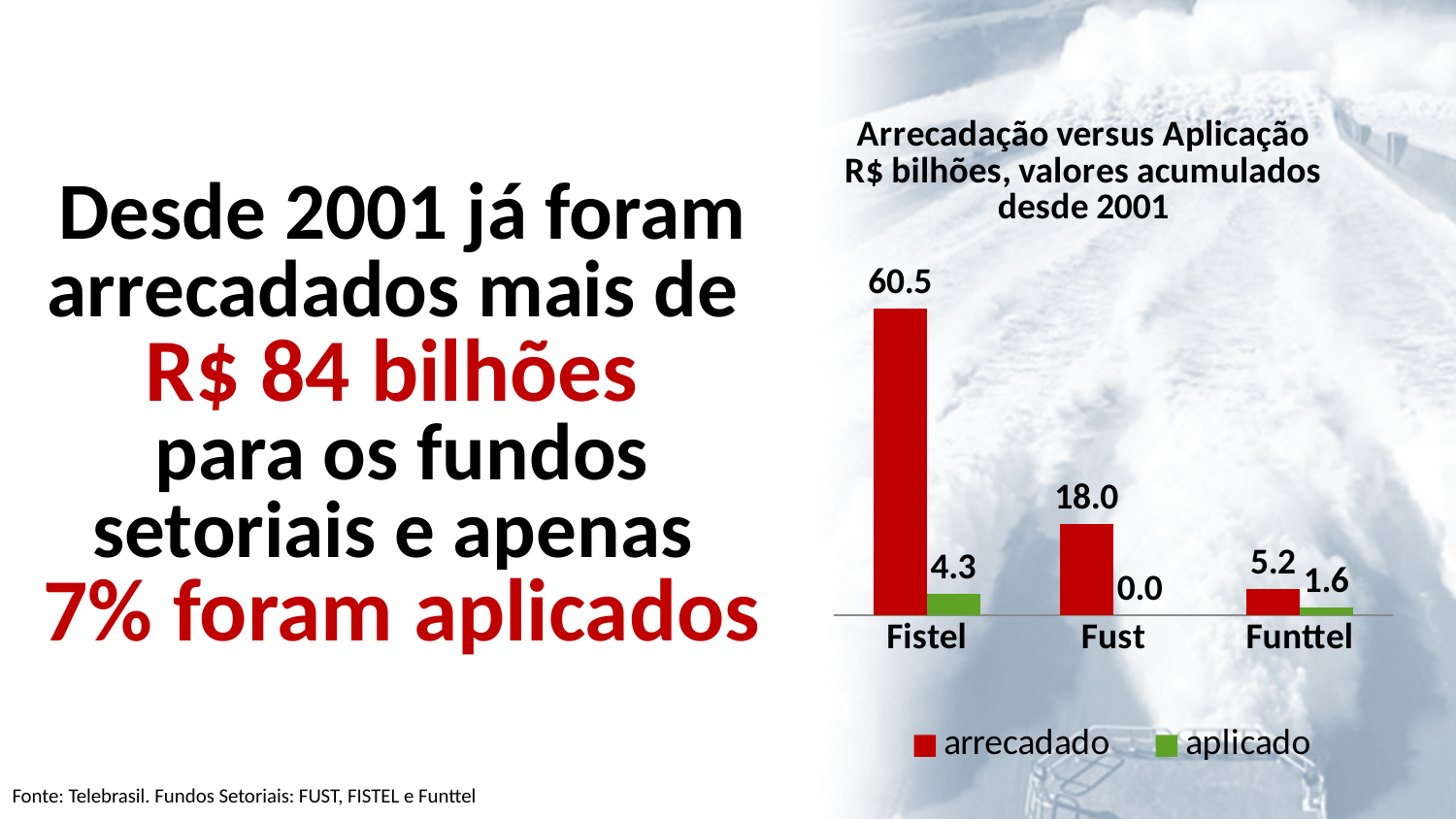
What is the 'arrecadado' value for Fust? 18.0 What is the 'arrecadado' value for Fistel? 60.5 How many series does the legend list? 2 Which is larger: the 'arrecadado' value for Fust or the 'arrecadado' value for Funttel? Fust What is the difference between the 'arrecadado' and 'aplicado' values for Fistel? 56.2 How many categories are shown on the x axis of the chart? 3 What is the title of the chart? Arrecadação versus Aplicação R$ bilhões, valores acumulados desde 2001 Which category has the lowest 'aplicado' value? Fust What is the 'aplicado' value for Fust? 0.0 Which category has the highest 'arrecadado' value? Fistel What is the 'aplicado' value for Funttel? 1.6 What kind of chart is shown on the slide? Bar chart